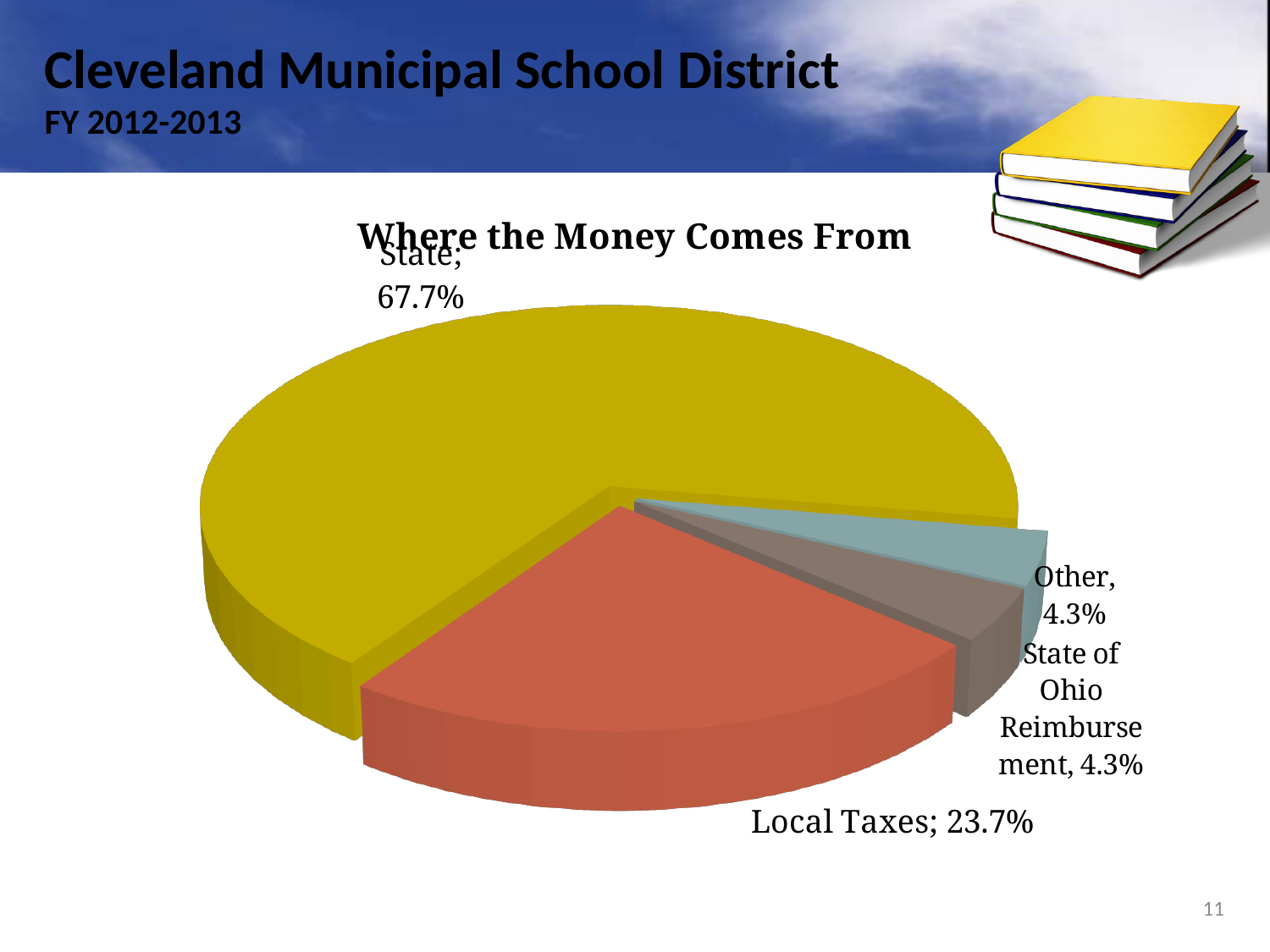
Which category has the largest slice of the pie? State What share of the pie does Local Taxes represent? 23.7% What colour is the State slice? Yellow How many slices does the pie chart have? 4 Which is larger, the Local Taxes slice or the Other slice? Local Taxes What is the difference in percentage points between the State slice and the Local Taxes slice? 44 percentage points What share of the pie does State of Ohio Reimbursement represent? 4.3% What kind of chart is shown on the slide? Pie chart What share of the pie does State represent? 67.7% What is the combined share of the Other and State of Ohio Reimbursement slices? 8.6% What is the title of the chart? Where the Money Comes From What share of the pie does Other represent? 4.3%